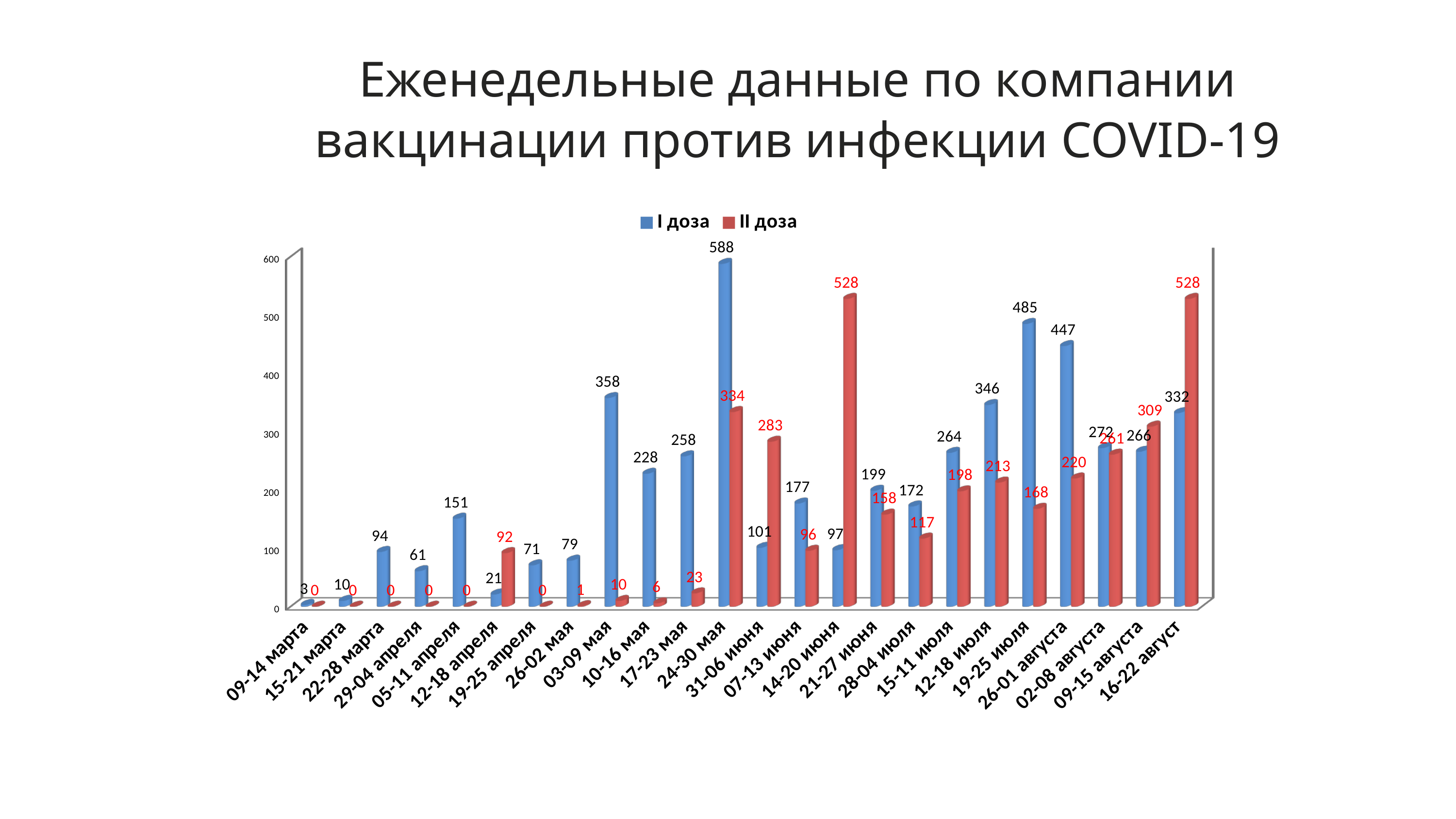
How many series does the legend list? 2 What colour represents II доза in the chart? red What is the value of II доза for the week 14-20 июня? 528 What is the value of I доза for the week 19-25 июля? 485 Which week has the lowest value for I доза? 09-14 марта What type of chart is shown on the slide? bar chart What is the difference between I доза and II доза for the week 16-22 август? 196 For the week 31-06 июня, which is larger: I доза or II доза? II доза How many weeks (categories) are shown on the x axis? 24 What is the value of II доза for the week 12-18 апреля? 92 What is the value of I доза for the week 24-30 мая? 588 Which week has the highest value for I доза? 24-30 мая